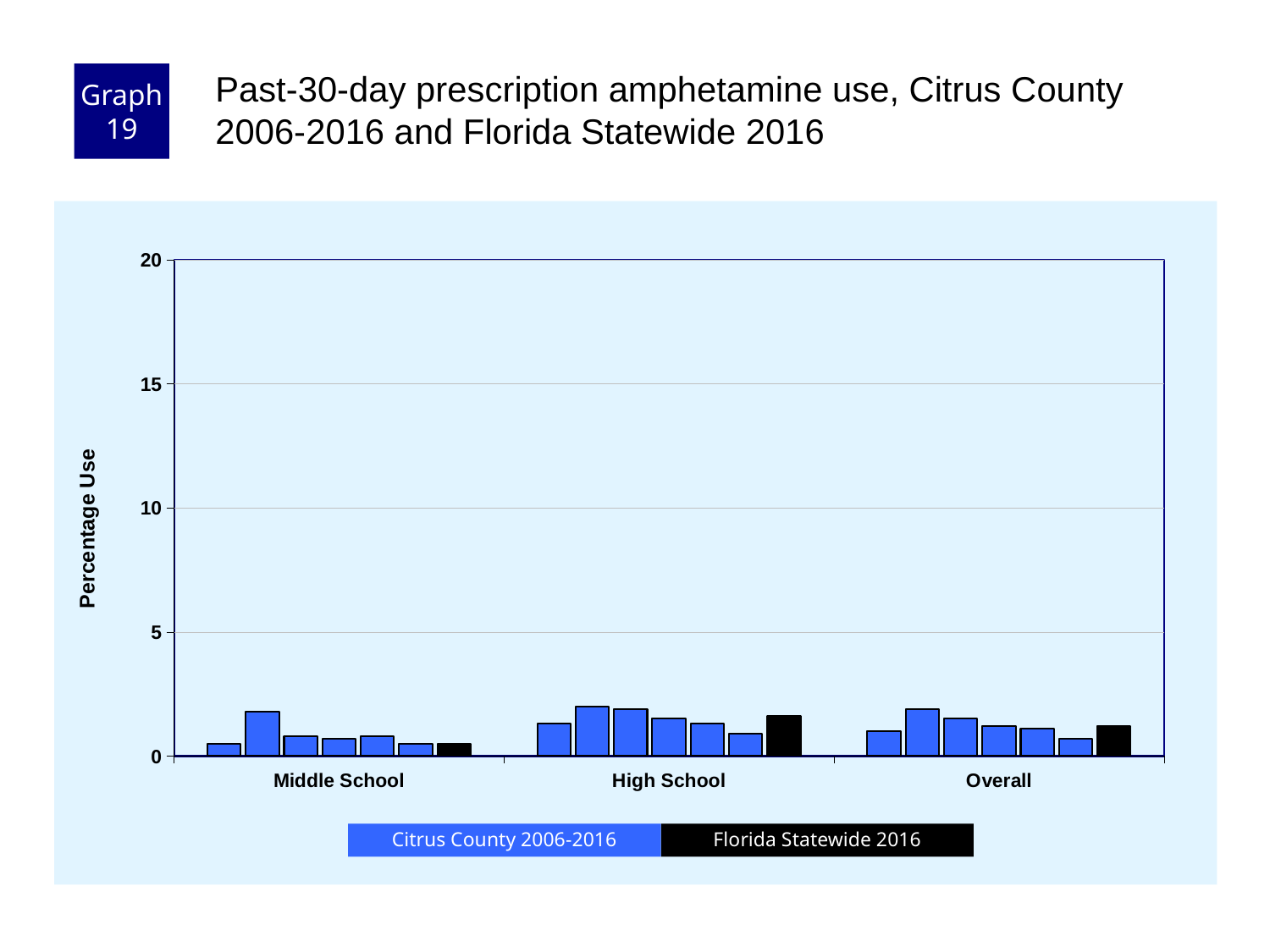
Is the Florida Statewide 2016 value for Middle School greater or less than 5? less Which series is shown in black in the legend? Florida Statewide 2016 Among the Florida Statewide 2016 bars, which category has the lowest value? Middle School How many series does the legend list? 2 What is the label of the y axis? Percentage Use Is the Florida Statewide 2016 value for Overall greater or less than 5? less For Florida Statewide 2016, is the value for High School or Middle School larger? High School Is the Florida Statewide 2016 value for High School greater or less than 5? less For Florida Statewide 2016, is the value for Overall or Middle School larger? Overall Among the Florida Statewide 2016 bars, which category has the highest value? High School What kind of chart is shown on the slide? bar chart How many school-level categories are shown on the x axis? 3